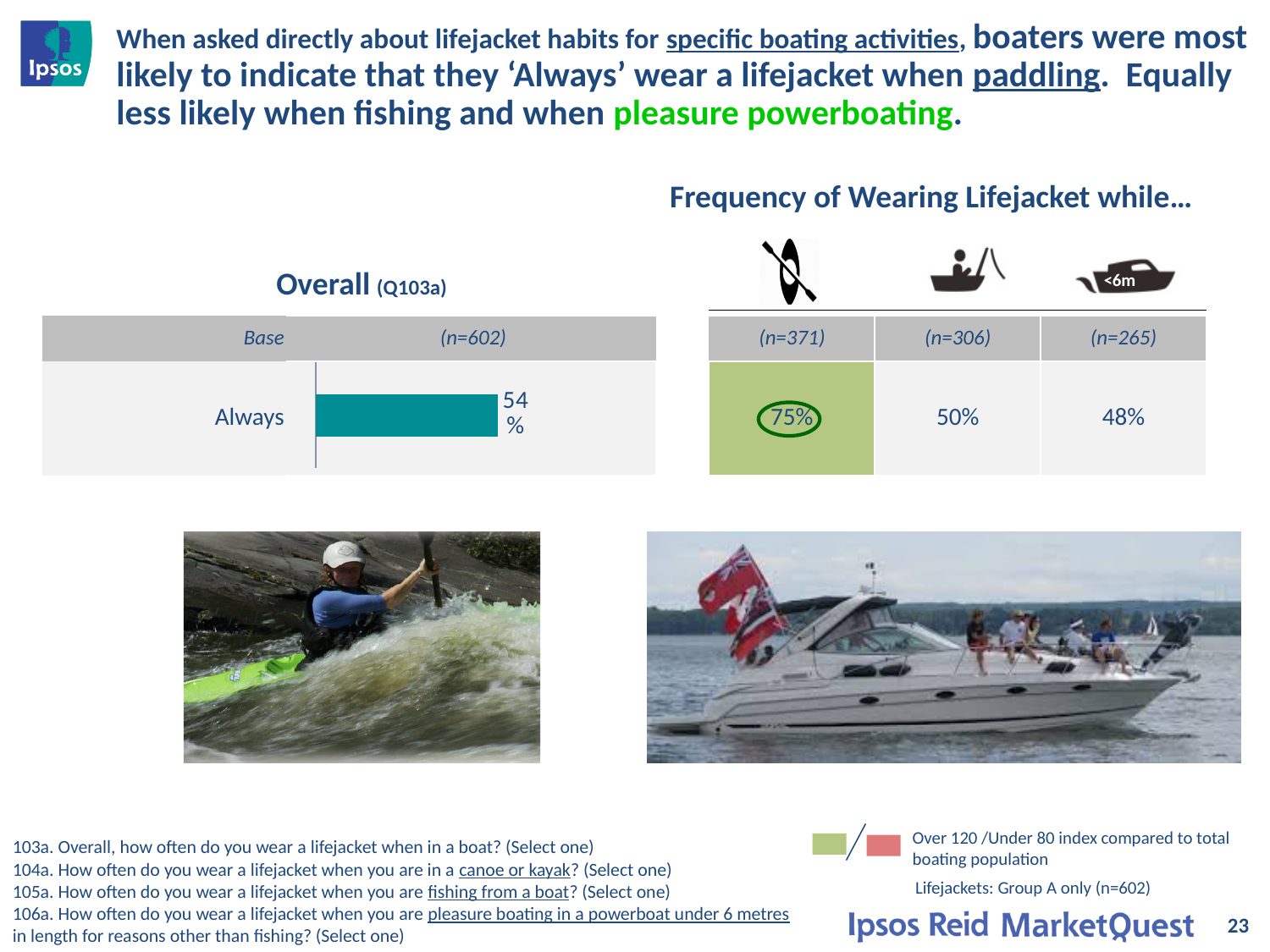
What is the value for 'Always' in the Overall (Q103a) chart? 54% In the 'Frequency of Wearing Lifejacket while…' table, which column has the highest percentage? n=371 (75%) Which is larger: the 'Always' value in the Overall (Q103a) chart or the 48% value in the 'Frequency of Wearing Lifejacket while…' table? the Overall 'Always' value (54%) Is the value for 'Always' in the Overall (Q103a) chart greater or less than 50%? greater In the 'Frequency of Wearing Lifejacket while…' table, what is the percentage shown in the column with base n=371? 75% What is the difference between the 75% in the 'Frequency of Wearing Lifejacket while…' table and the 54% 'Always' value in the Overall (Q103a) chart? 21 percentage points In the 'Frequency of Wearing Lifejacket while…' table, what is the percentage shown in the column with base n=265? 48% What is the base size (n) shown for the Overall (Q103a) chart? n=602 What kind of chart is the Overall (Q103a) chart? bar chart What is the label of the single category plotted in the Overall (Q103a) chart? Always How many categories are plotted in the Overall (Q103a) chart? 1 In the 'Frequency of Wearing Lifejacket while…' table, what is the percentage shown in the column with base n=306? 50%